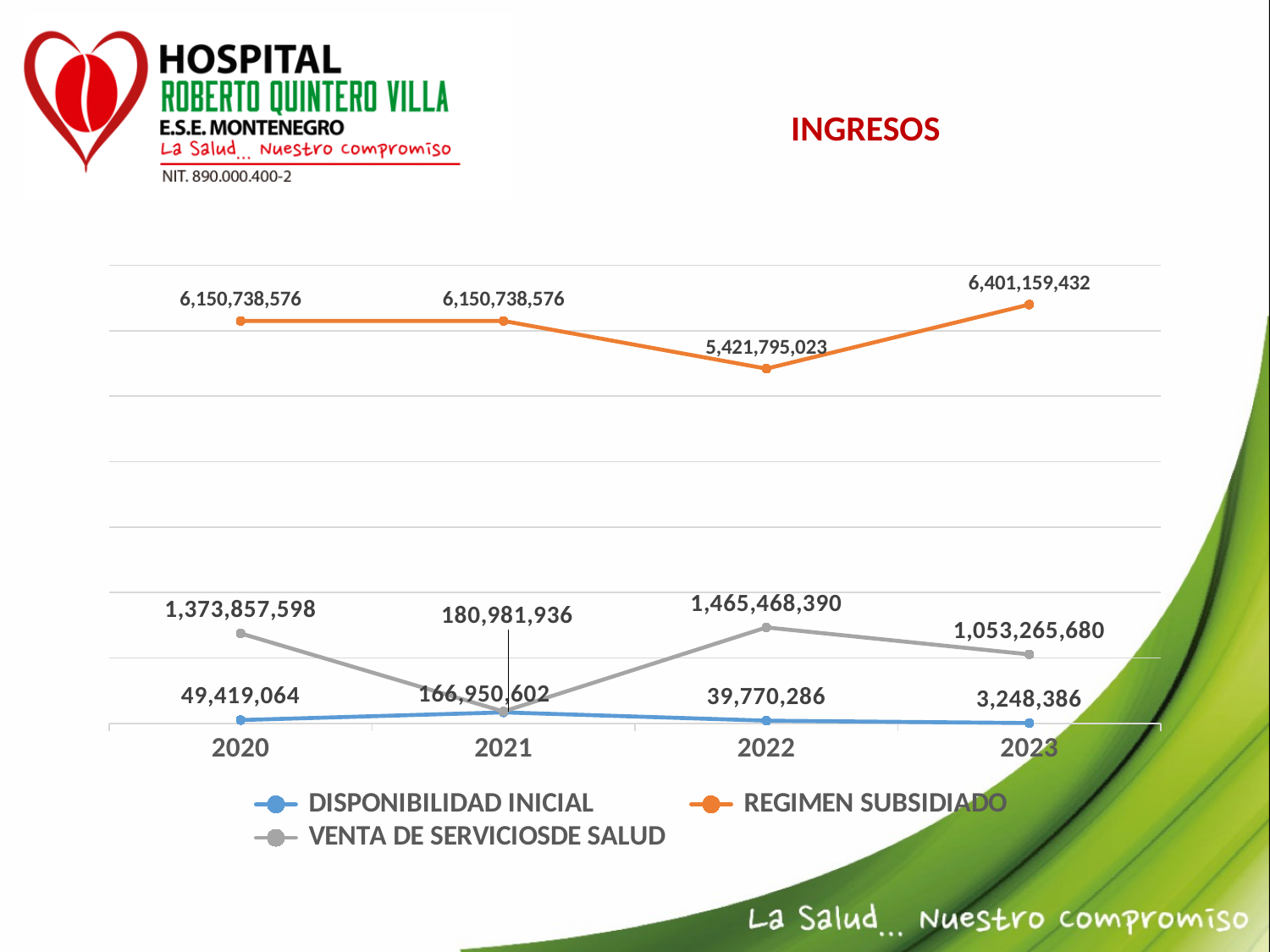
What is the value of DISPONIBILIDAD INICIAL in 2023? 3,248,386 What is the value of REGIMEN SUBSIDIADO in 2022? 5,421,795,023 How many years are shown on the x axis? 4 What is the difference between DISPONIBILIDAD INICIAL in 2020 and in 2022? 9,648,778 Which is larger in 2020: VENTA DE SERVICIOS DE SALUD or DISPONIBILIDAD INICIAL? VENTA DE SERVICIOS DE SALUD What kind of chart is shown on the slide? line chart What is the title of the chart? INGRESOS What is the value of VENTA DE SERVICIOS DE SALUD in 2020? 1,373,857,598 What is the value of REGIMEN SUBSIDIADO in 2023? 6,401,159,432 In which year is VENTA DE SERVICIOS DE SALUD highest? 2022 How many series does the legend list? 3 In which year is REGIMEN SUBSIDIADO lowest? 2022